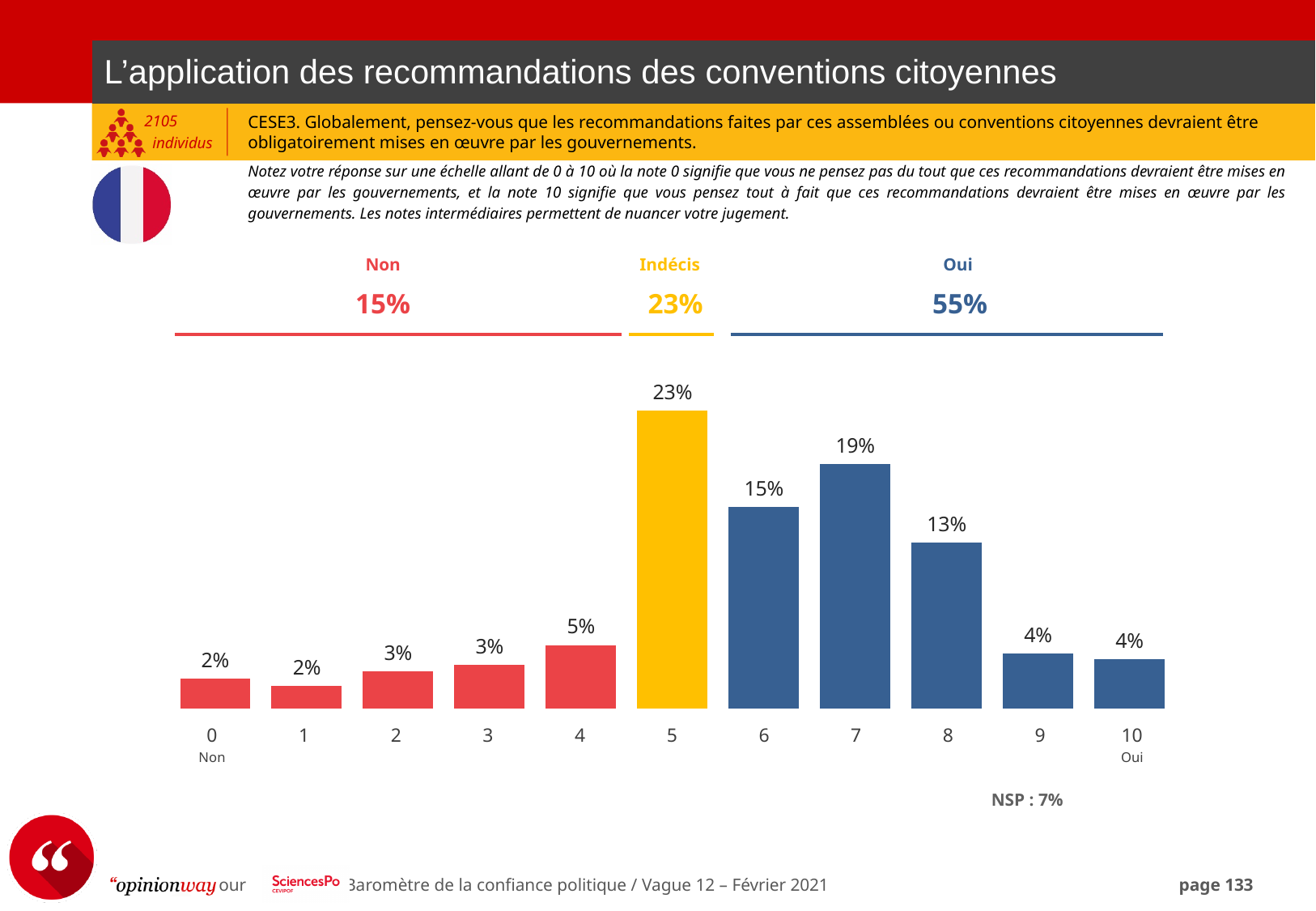
What percentage of respondents gave a score of 0? 2% What is the difference in percentage points between the score 6 bar and the score 8 bar? 2 How many score categories are shown on the x axis of the bar chart? 11 What percentage of respondents gave a score of 7? 19% What percentage is given for NSP (no answer) below the chart? 7% What percentage of respondents gave a score of 5? 23% Which score on the 0 to 10 scale has the highest percentage of respondents? 5 What colour are the bars for scores 6 to 10? Blue Do the percentages rise or fall from score 7 to score 10? Fall Which has a higher percentage: score 4 or score 9? Score 4 What is the combined percentage for the 'Oui' group (scores 6 to 10) shown above the chart? 55% What kind of chart is shown on the slide? Bar chart